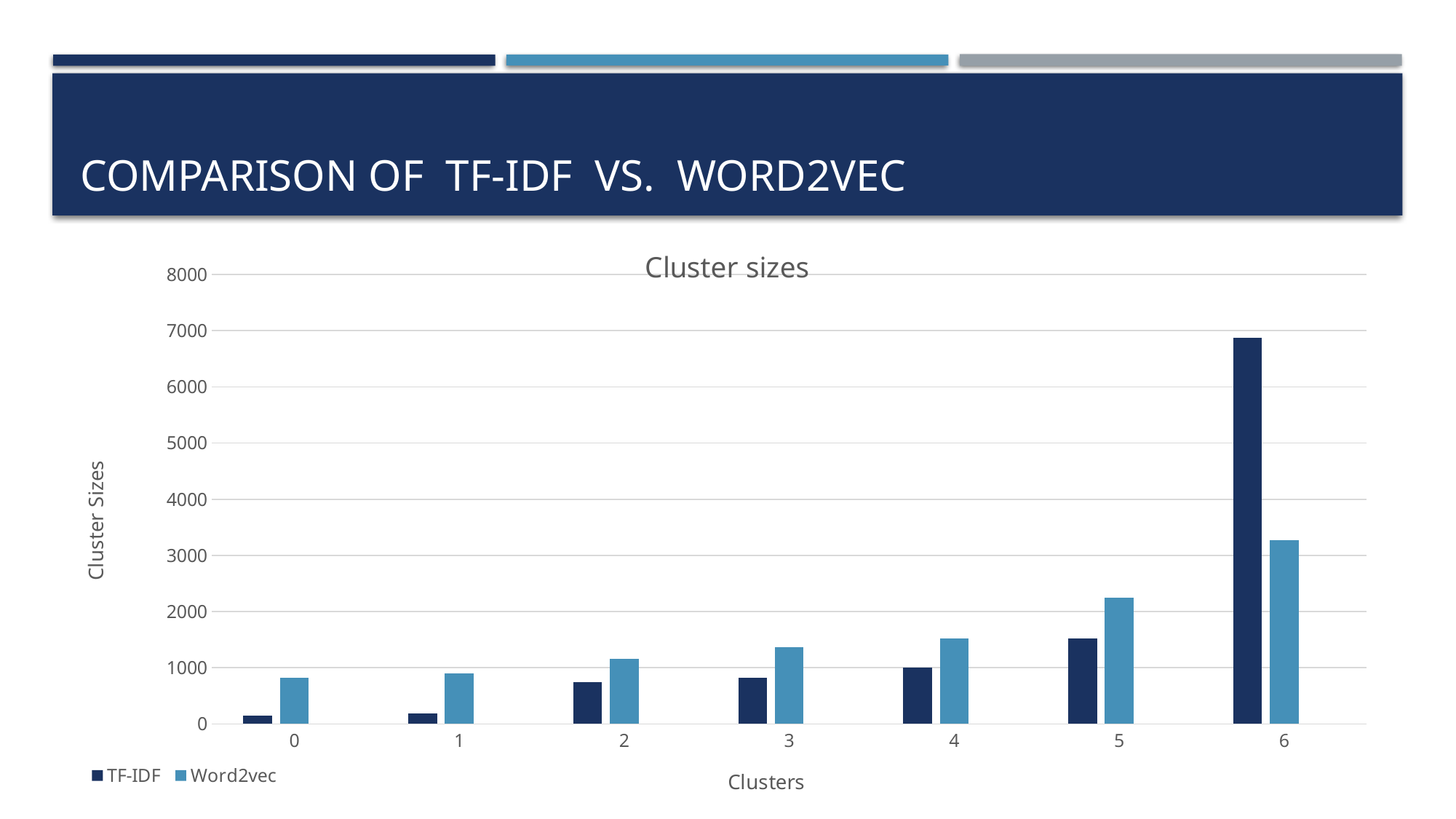
How many series does the legend list? 2 Is the Word2vec value for cluster 5 greater or less than 2000? greater Is the Word2vec value for cluster 6 greater or less than 3000? greater For cluster 6, which series has the larger value, TF-IDF or Word2vec? TF-IDF How many clusters are shown on the x axis? 7 What is the title of the chart? Cluster sizes Is the TF-IDF value for cluster 2 greater or less than 1000? less For cluster 5, which series has the larger value, TF-IDF or Word2vec? Word2vec Which cluster has the largest Word2vec cluster size? 6 What type of chart is shown on the slide? Bar chart Which cluster has the largest TF-IDF cluster size? 6